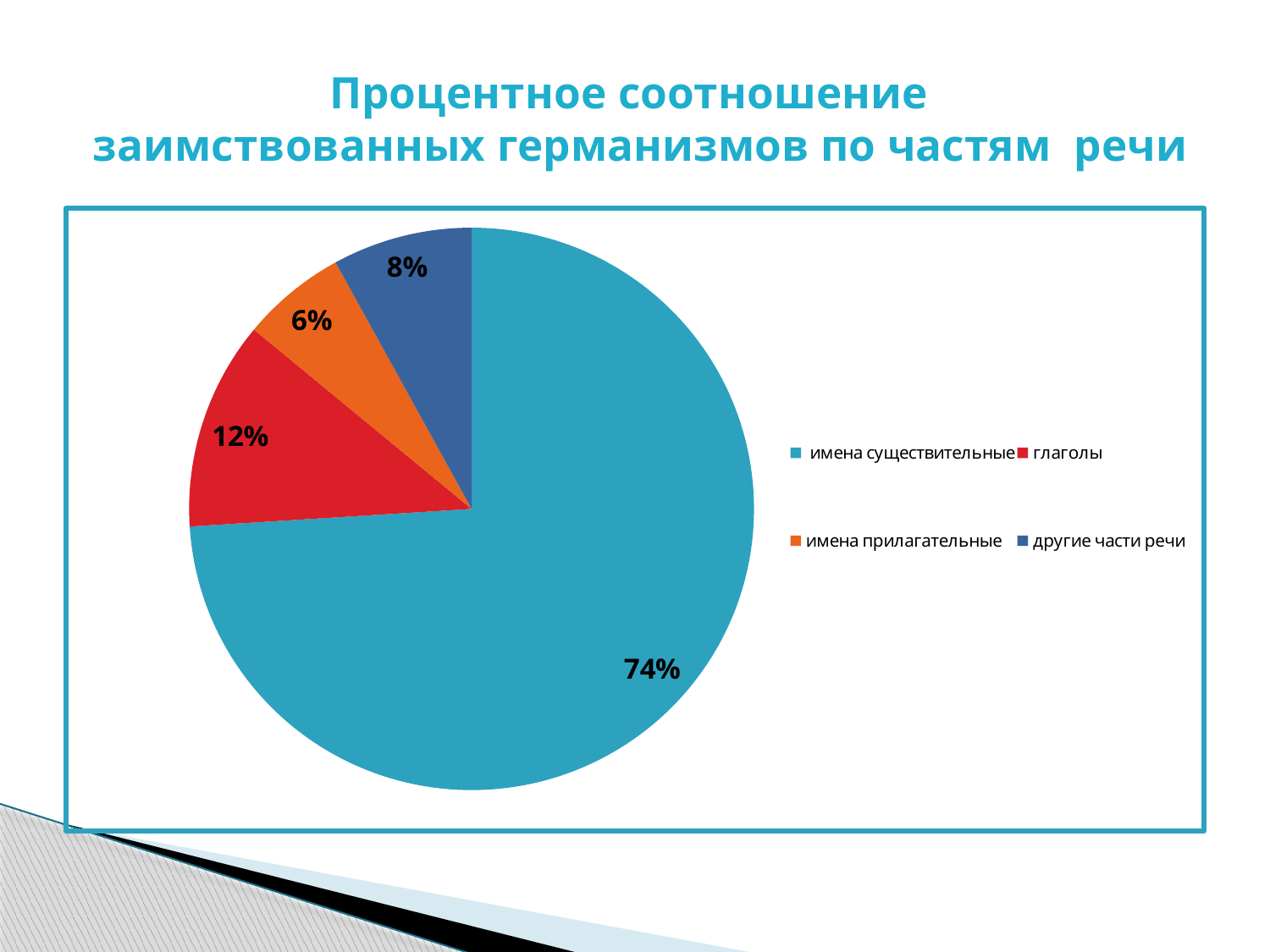
What share of the pie is labelled for глаголы? 12% Which is larger, the share for глаголы or the share for другие части речи? глаголы What share of the pie is labelled for имена прилагательные? 6% What is the difference in percentage points between другие части речи and имена прилагательные? 2 What is the difference in percentage points between имена существительные and глаголы? 62 What type of chart is shown on the slide? pie chart What share of the pie is labelled for имена существительные? 74% What colour is the slice for глаголы? red How many categories does the pie chart show? 4 Which category has the smallest slice of the pie? имена прилагательные Which category has the largest slice of the pie? имена существительные